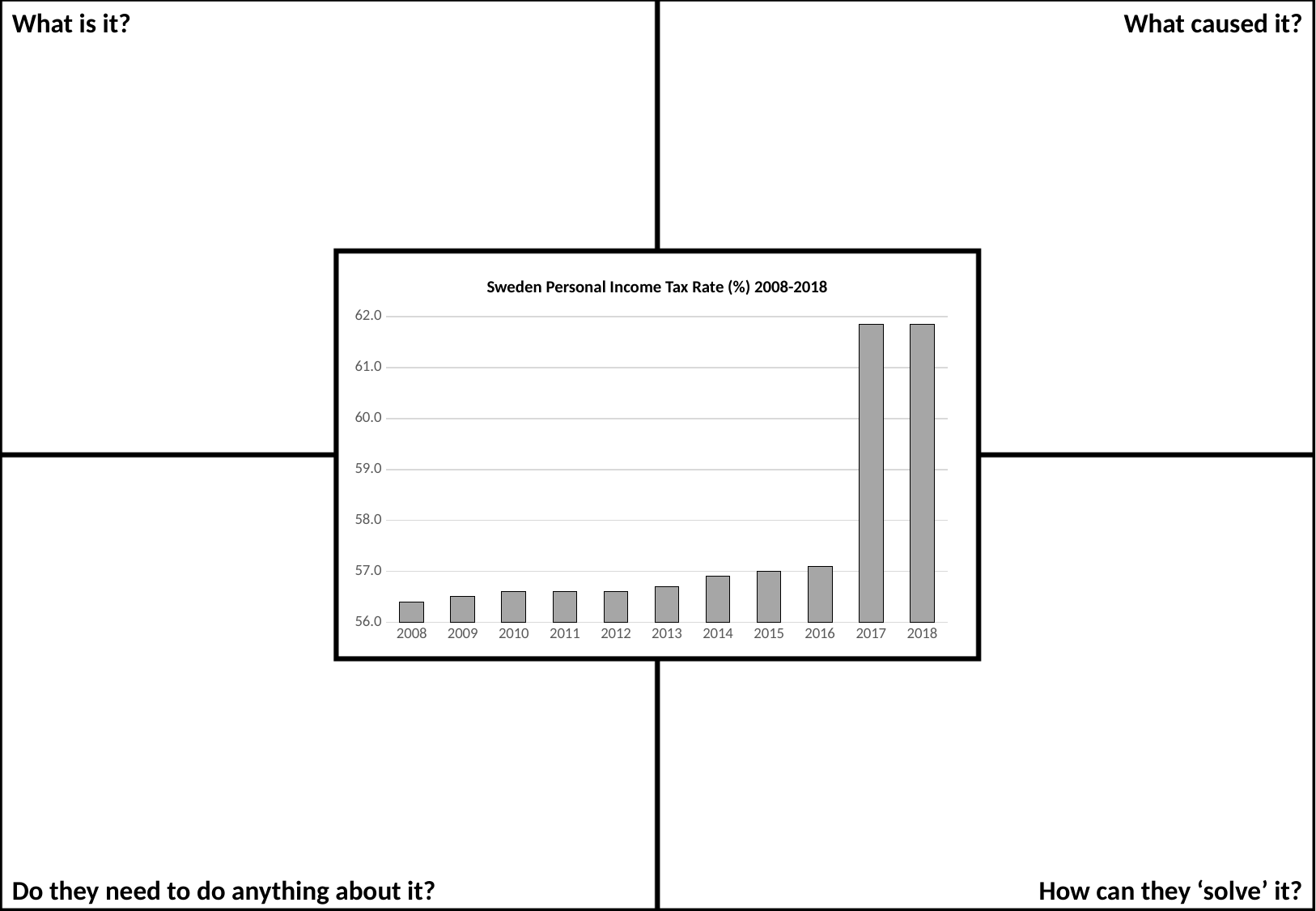
Which year has the lowest personal income tax rate in the chart? 2008 Is the value for 2018 greater or less than 60.0? greater Which is larger, the value for 2017 or the value for 2016? 2017 Is the value for 2016 greater or less than 58.0? less How many years are shown on the x axis of the chart? 11 What kind of chart is shown on the slide? bar chart Is the value for 2008 greater or less than 57.0? less Do the values generally rise or fall from 2008 to 2018? rise What is the title of the chart? Sweden Personal Income Tax Rate (%) 2008-2018 What colour are the bars in the chart? grey